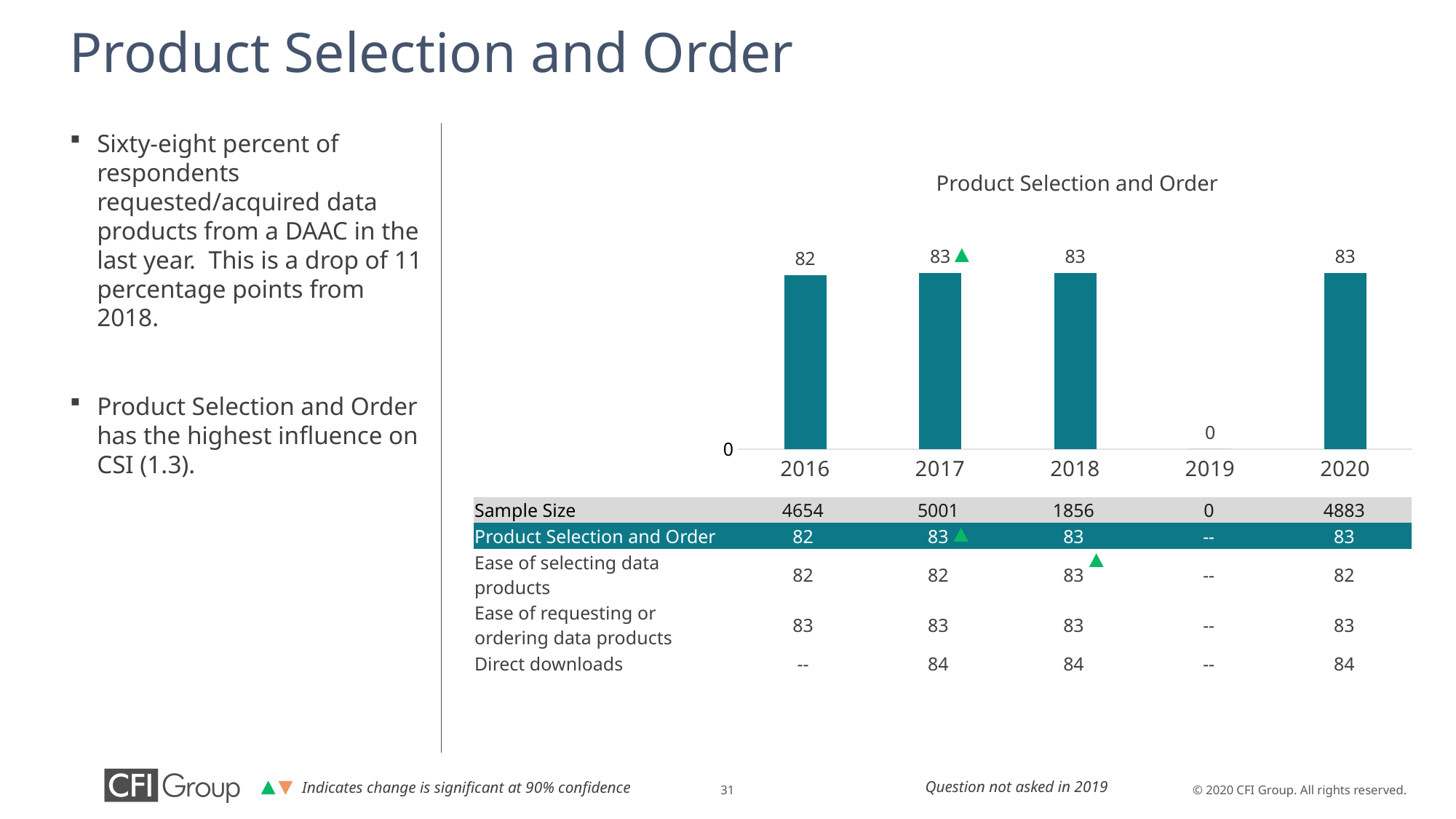
What is the value for 2018 in the Product Selection and Order chart? 83 How many years are shown on the x axis of the Product Selection and Order chart? 5 What is the value for 2016 in the Product Selection and Order chart? 82 What is the value for 2020 in the Product Selection and Order chart? 83 Which year's bar in the Product Selection and Order chart is marked with a green triangle indicating a significant change? 2017 Which is larger in the Product Selection and Order chart, the value for 2016 or the value for 2020? 2020 Which year has the lowest non-zero value in the Product Selection and Order chart? 2016 What is the title of the chart on the slide? Product Selection and Order What is the difference between the 2017 and 2016 values in the Product Selection and Order chart? 1 What value is shown for 2019 in the Product Selection and Order chart? 0 What kind of chart is the Product Selection and Order chart? bar chart Did the Product Selection and Order value rise or fall from 2016 to 2017? rise